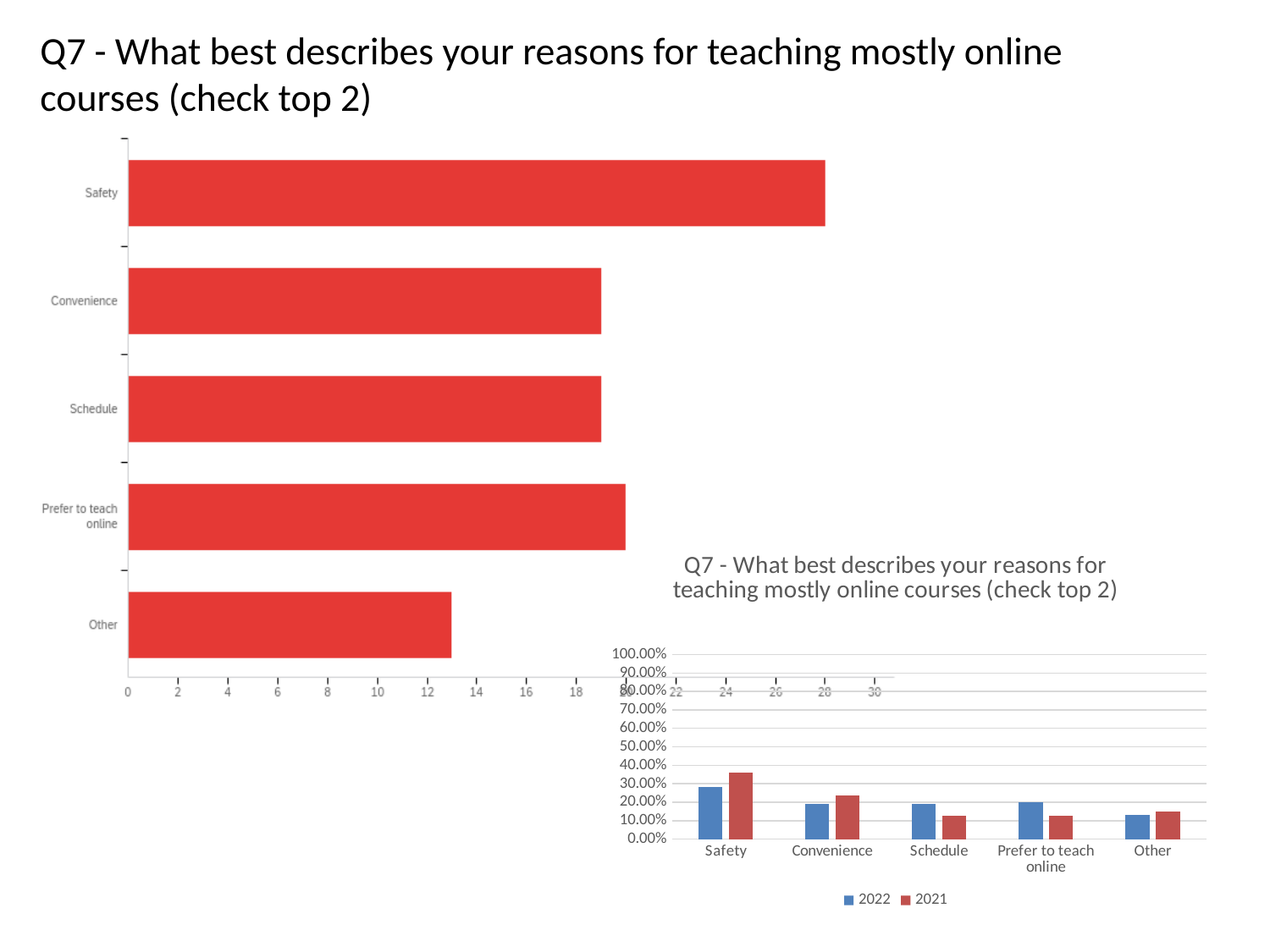
How many series does the legend of the chart on the lower right list? 2 In the chart on the lower right, is the 2021 value for Prefer to teach online greater or less than 20.00%? less In the large chart on the left, is the value for Safety greater or less than 20? greater In the chart on the lower right, is the 2021 value for Safety greater or less than 30.00%? greater How many categories does the large chart on the left show? 5 In the large chart on the left, which category has the lowest value? Other What kind of chart is the large chart on the left of the slide? bar chart In the chart on the lower right, which is larger for Safety: 2022 or 2021? 2021 In the large chart on the left, which category has the highest value? Safety In the chart on the lower right, which is larger for Schedule: 2022 or 2021? 2022 What are the legend entries of the chart on the lower right? 2022 and 2021